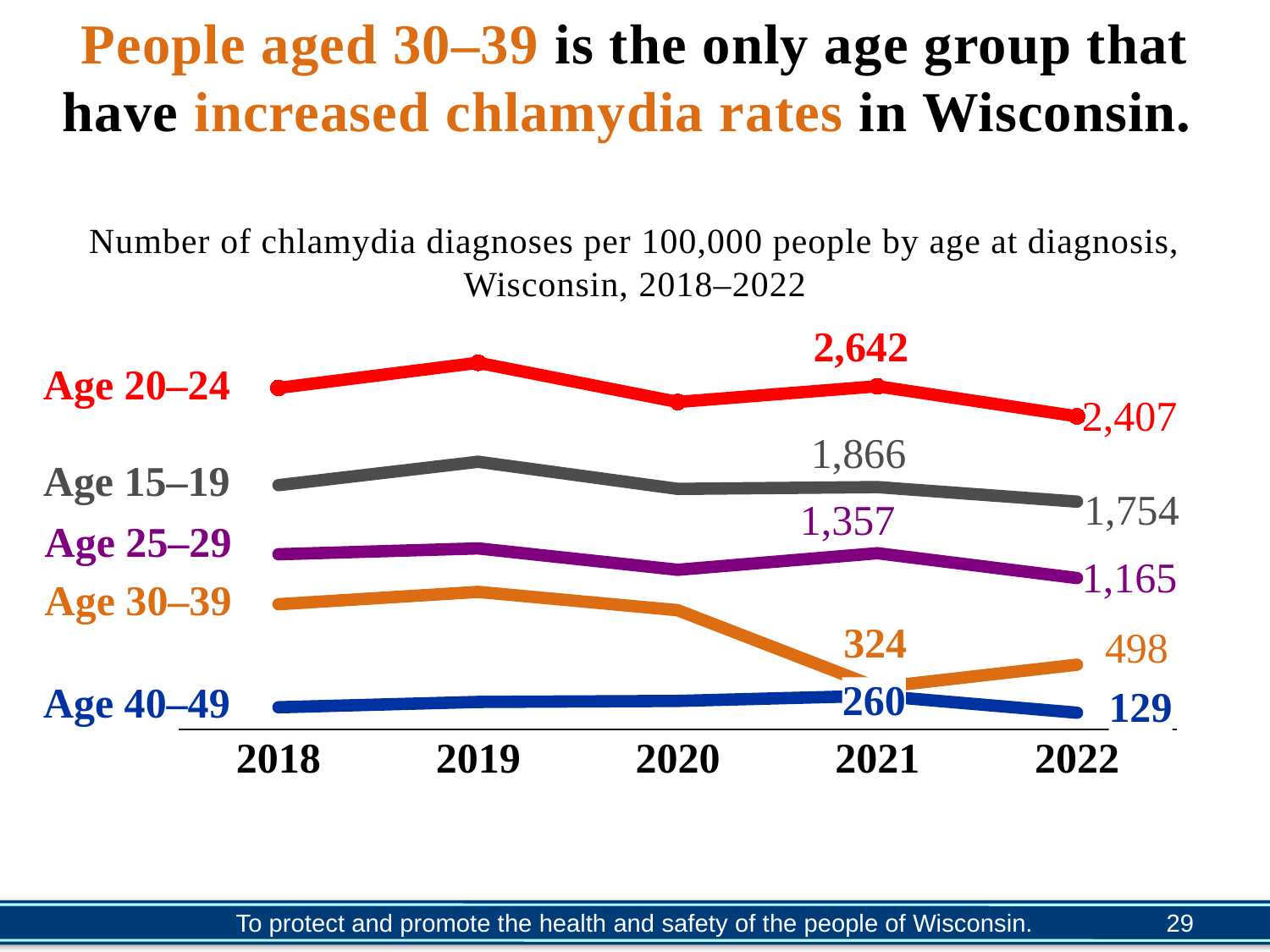
How many years are shown on the x axis? 5 What was the chlamydia rate for Age 20–24 in 2022? 2,407 Which age group had the highest chlamydia rate in 2022? Age 20–24 What is the difference between the 2022 rates for Age 25–29 and Age 30–39? 667 Which was larger in 2021, the rate for Age 30–39 or Age 40–49? Age 30–39 What was the chlamydia rate for Age 15–19 in 2021? 1,866 How many age groups are plotted on the chart? 5 By how much did the chlamydia rate for Age 20–24 change from 2021 to 2022? 235 What was the chlamydia rate for Age 40–49 in 2021? 260 What was the chlamydia rate for Age 30–39 in 2022? 498 Which age group had the lowest chlamydia rate in 2022? Age 40–49 What type of chart is shown on the slide? Line chart